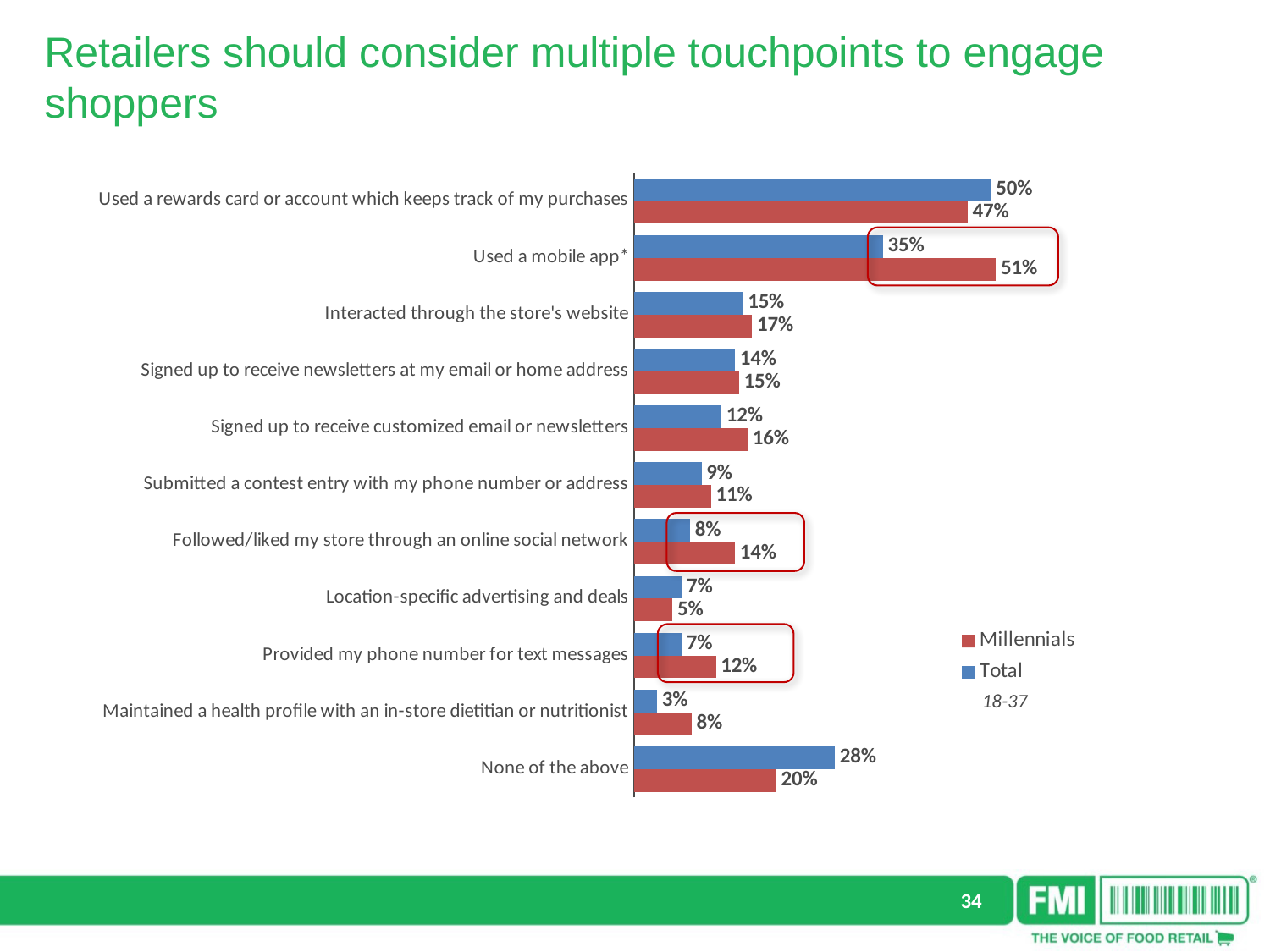
How many categories are shown in the chart? 11 How many series does the legend list? 2 What is the Total value for "Maintained a health profile with an in-store dietitian or nutritionist"? 3% For "Location-specific advertising and deals", which is larger: the Total value or the Millennials value? Total What is the difference between the Total and Millennials values for "None of the above"? 8% Which category has the lowest Total value? Maintained a health profile with an in-store dietitian or nutritionist Which category has the highest Millennials value? Used a mobile app* What is the Total value for "Used a rewards card or account which keeps track of my purchases"? 50% What kind of chart is shown on the slide? Bar chart What is the Millennials value for "Used a mobile app*"? 51% What is the Millennials value for "None of the above"? 20% What is the difference between the Millennials and Total values for "Used a mobile app*"? 16%